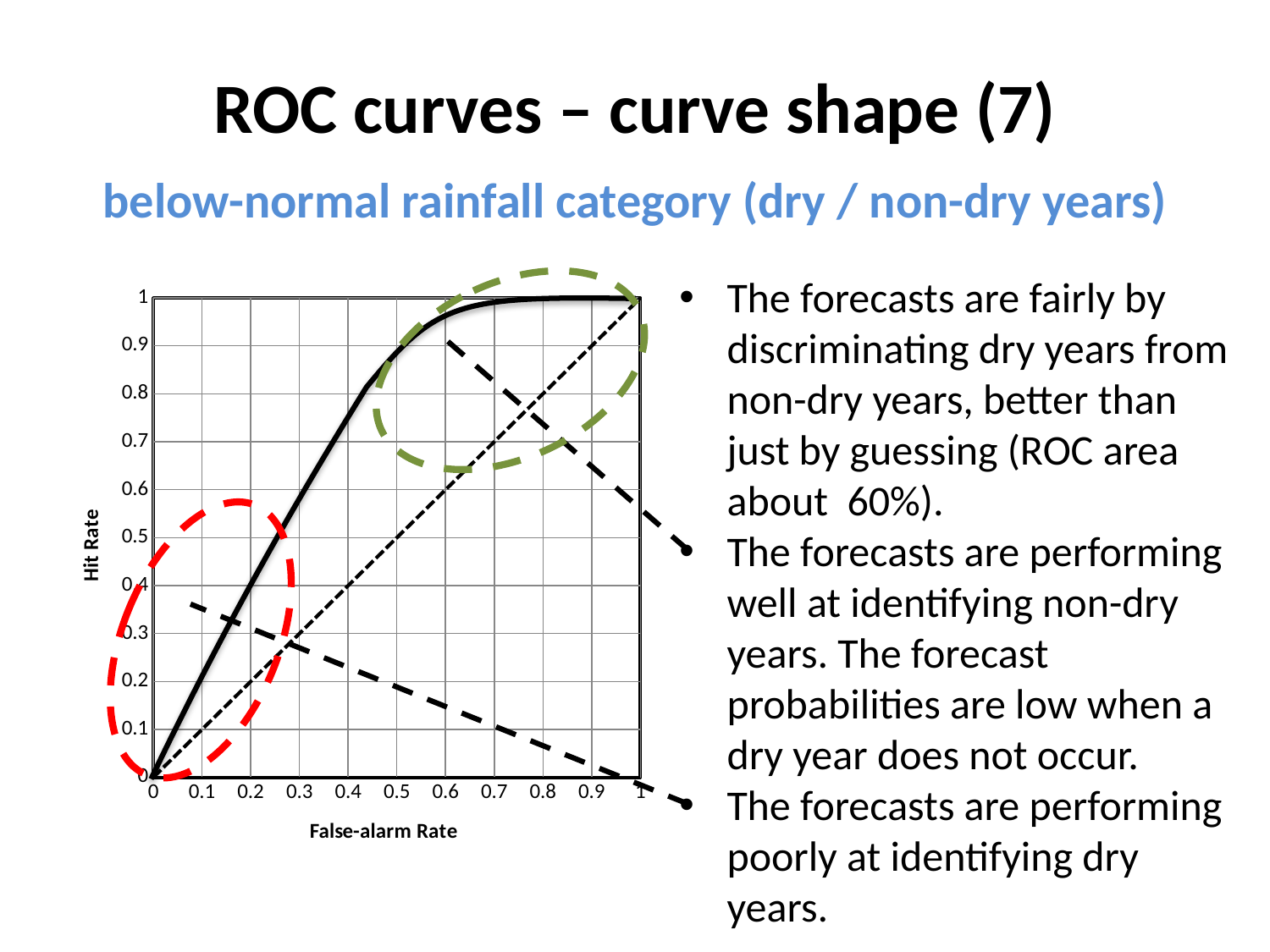
What is the highest value shown on the y axis of the chart? 1 What is the label of the x axis of the chart? False-alarm Rate What is the label of the y axis of the chart? Hit Rate Does the hit rate rise or fall as the false-alarm rate increases along the x axis? rise Is the hit rate of the solid curve at a false-alarm rate of 0.2 greater or less than 0.5? less Which has the higher hit rate on the solid curve: a false-alarm rate of 0.2 or a false-alarm rate of 0.5? 0.5 Is the hit rate of the solid curve at a false-alarm rate of 0.1 greater or less than 0.3? less Is the hit rate of the solid curve at a false-alarm rate of 0.4 greater or less than 0.7? greater What kind of chart is shown on the slide? line chart At a false-alarm rate of 0.3, is the solid ROC curve above or below the diagonal dashed line? above